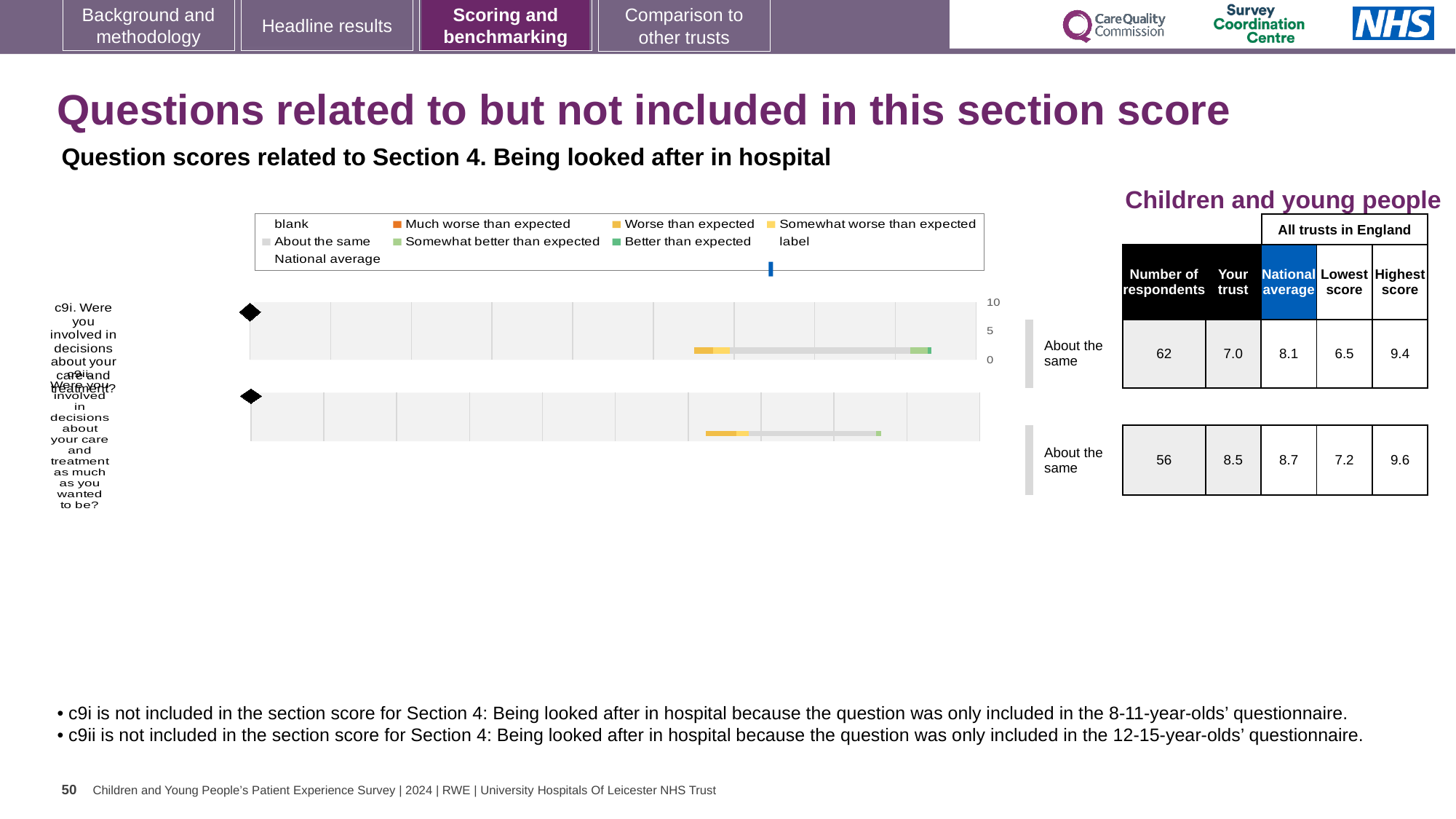
What is the lowest score across all trusts in England for question c9ii? 7.2 How many questions are plotted in the chart? 2 What is the maximum value shown on the chart's score axis? 10 What is the title of the chart? Question scores related to Section 4. Being looked after in hospital How many respondents answered question c9i? 62 What is the national average score for question c9ii? 8.7 What is the 'Your trust' score for question c9i? 7.0 What kind of chart is used to show the question scores for c9i and c9ii? bar chart How much higher is the national average than the 'Your trust' score for question c9i? 1.1 What benchmark category is shown for question c9i? About the same Which question has the higher 'Your trust' score, c9i or c9ii? c9ii What is the difference between the highest score and the lowest score for question c9i? 2.9